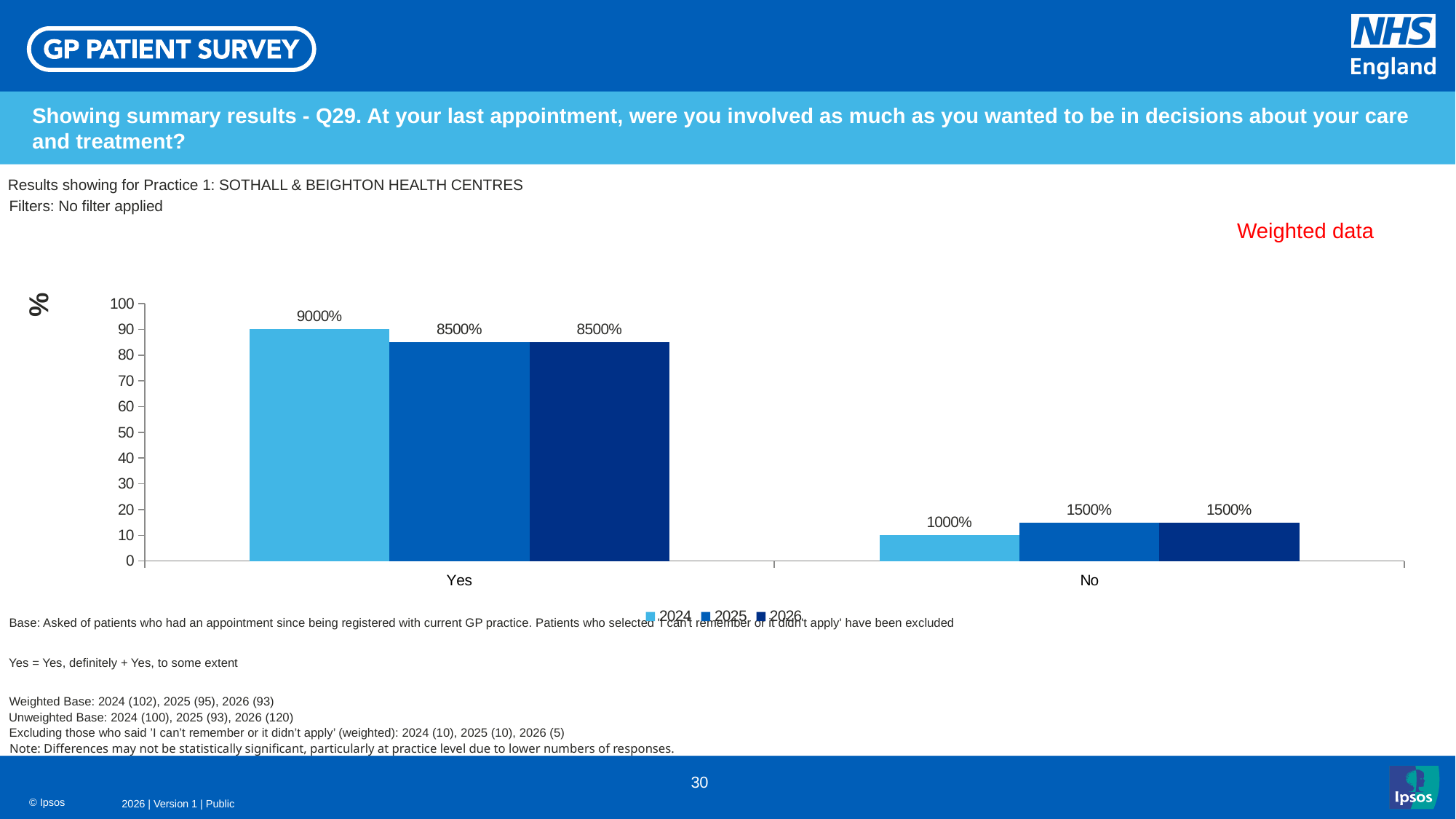
What is the data label for the 2026 series in the No category? 1500% What is the data label for the 2024 series in the No category? 1000% Which year has the lowest bar in the No category? 2024 What are the series names listed in the legend? 2024, 2025, 2026 Is the 2024 bar for Yes larger or smaller than the 2026 bar for Yes? larger Is the 2025 bar for No greater or less than 10 on the y axis? greater How many series does the legend list? 3 What kind of chart is shown on the slide? bar chart How many categories are shown on the x axis? 2 Which year has the highest bar in the Yes category? 2024 What is the data label for the 2024 series in the Yes category? 9000% What is the data label for the 2025 series in the Yes category? 8500%